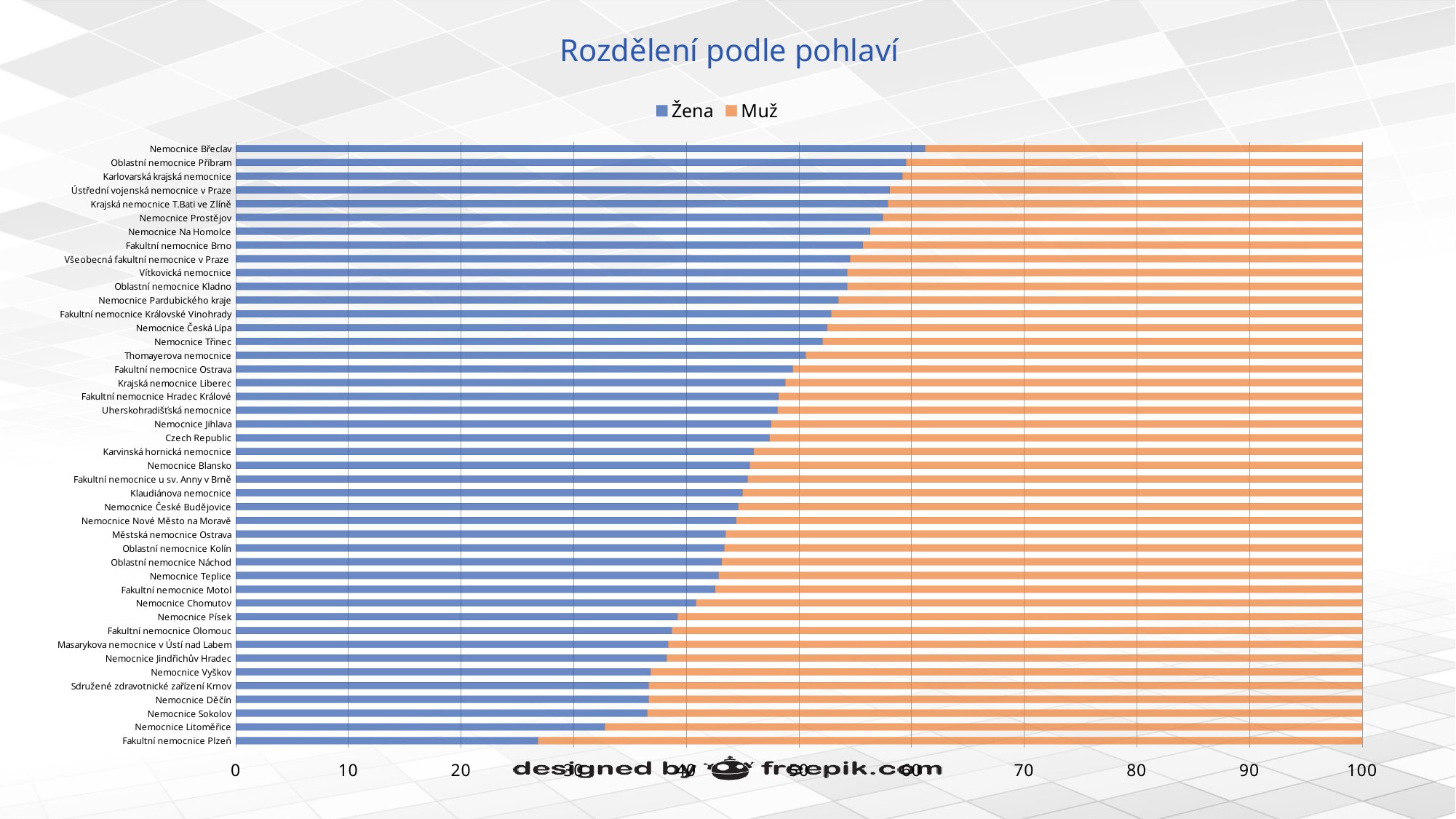
Which two series are listed in the legend? Žena and Muž Is the Žena value for Fakultní nemocnice Plzeň greater or less than 30? less Which category has the highest Žena share? Nemocnice Břeclav What kind of chart is shown on the slide? bar chart Is the Žena value for Nemocnice Břeclav greater or less than 60? greater What is the title of the chart? Rozdělení podle pohlaví Which category has the lowest Žena share? Fakultní nemocnice Plzeň How many series does the legend list? 2 Is the Žena value for Czech Republic greater or less than 50? less What is the total of the stacked bar for Nemocnice Jihlava (Žena plus Muž)? 100 How many hospitals (categories) are plotted in the chart? 44 Which has a larger Žena share, Nemocnice Břeclav or Fakultní nemocnice Motol? Nemocnice Břeclav